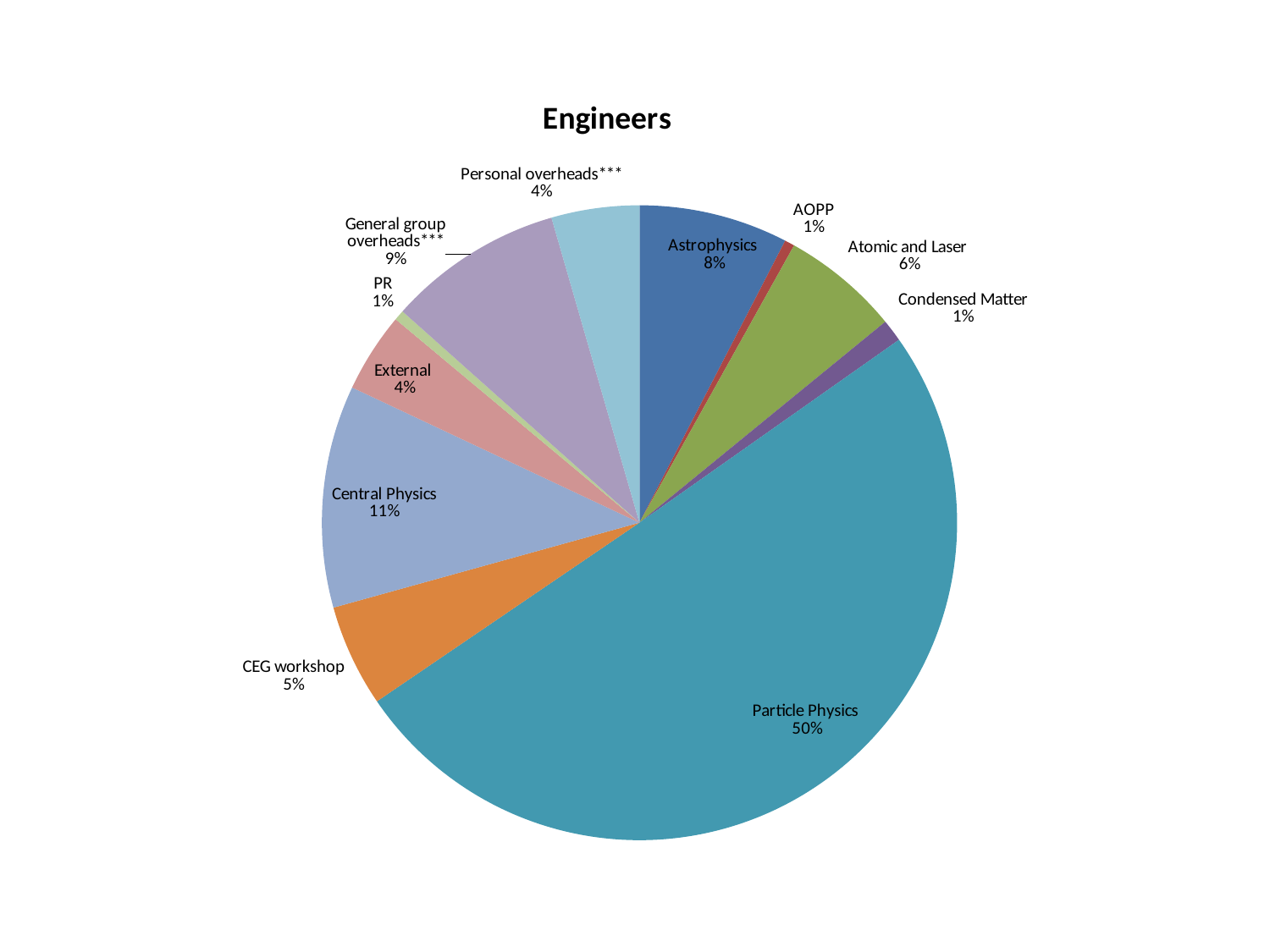
What share of the pie does Particle Physics have? 50% What share of the pie does Central Physics have? 11% Which is larger, the share for Astrophysics or the share for CEG workshop? Astrophysics What is the difference between the shares of Particle Physics and Central Physics? 39% How many categories are shown in the pie chart? 11 What is the title of the chart? Engineers What is the value shown for Personal overheads***? 4% What is the value shown for Atomic and Laser? 6% Which category has the largest slice of the pie? Particle Physics What is the value shown for General group overheads***? 9% What kind of chart is shown on the slide? pie chart What is the difference between the shares of Central Physics and Astrophysics? 3%